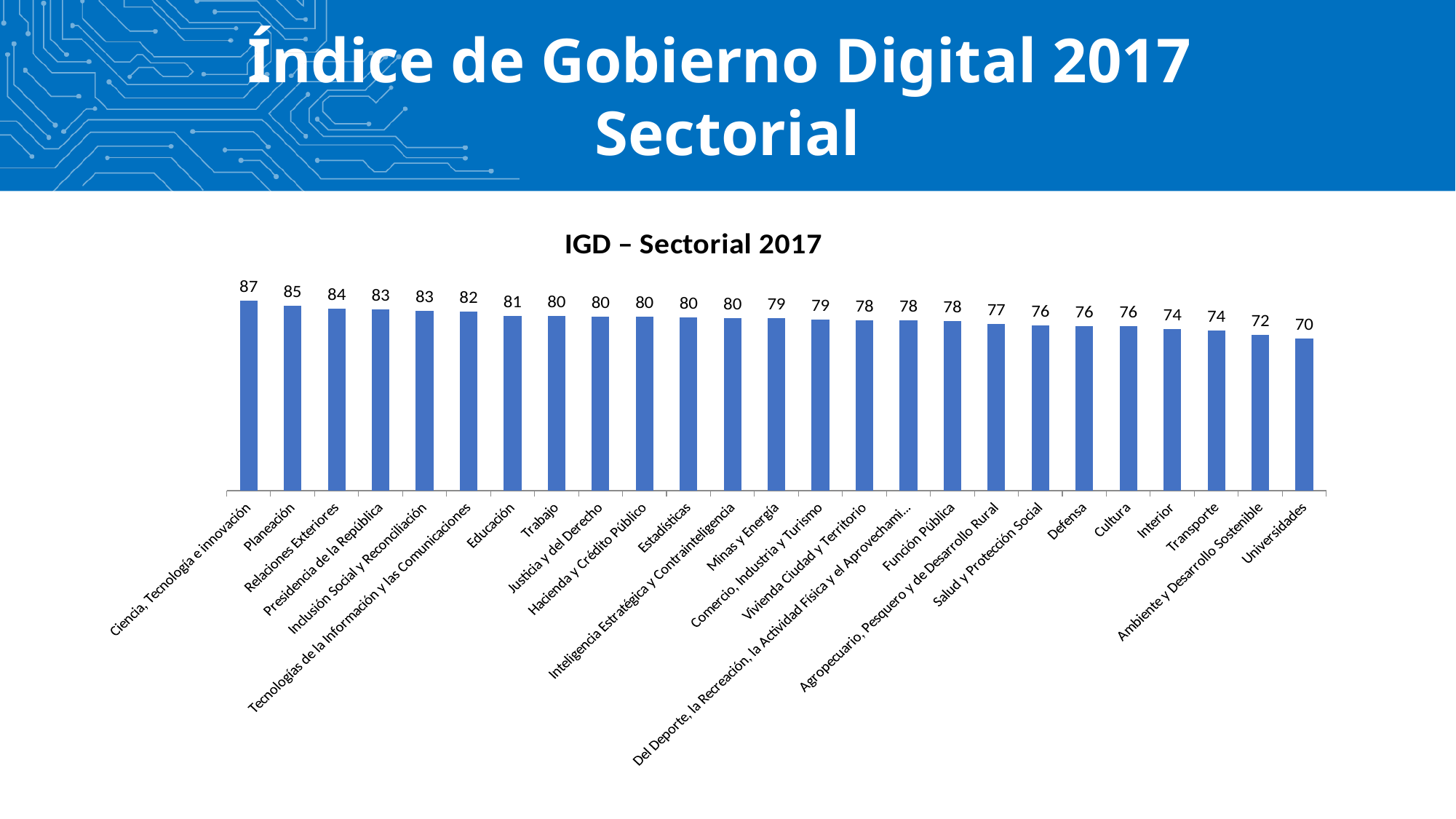
What is the value for Transporte? 74 What kind of chart is shown on the slide? Bar chart What is the difference between the values for Ciencia, Tecnología e innovación and Universidades? 17 Which category has the lowest value? Universidades What is the value for Planeación? 85 Which is larger, the value for Trabajo or the value for Interior? Trabajo What is the title of the chart? IGD – Sectorial 2017 What is the value for Educación? 81 Which category has the highest value? Ciencia, Tecnología e innovación What is the value for Defensa? 76 How many categories are shown in the chart? 25 What is the difference between the values for Relaciones Exteriores and Cultura? 8